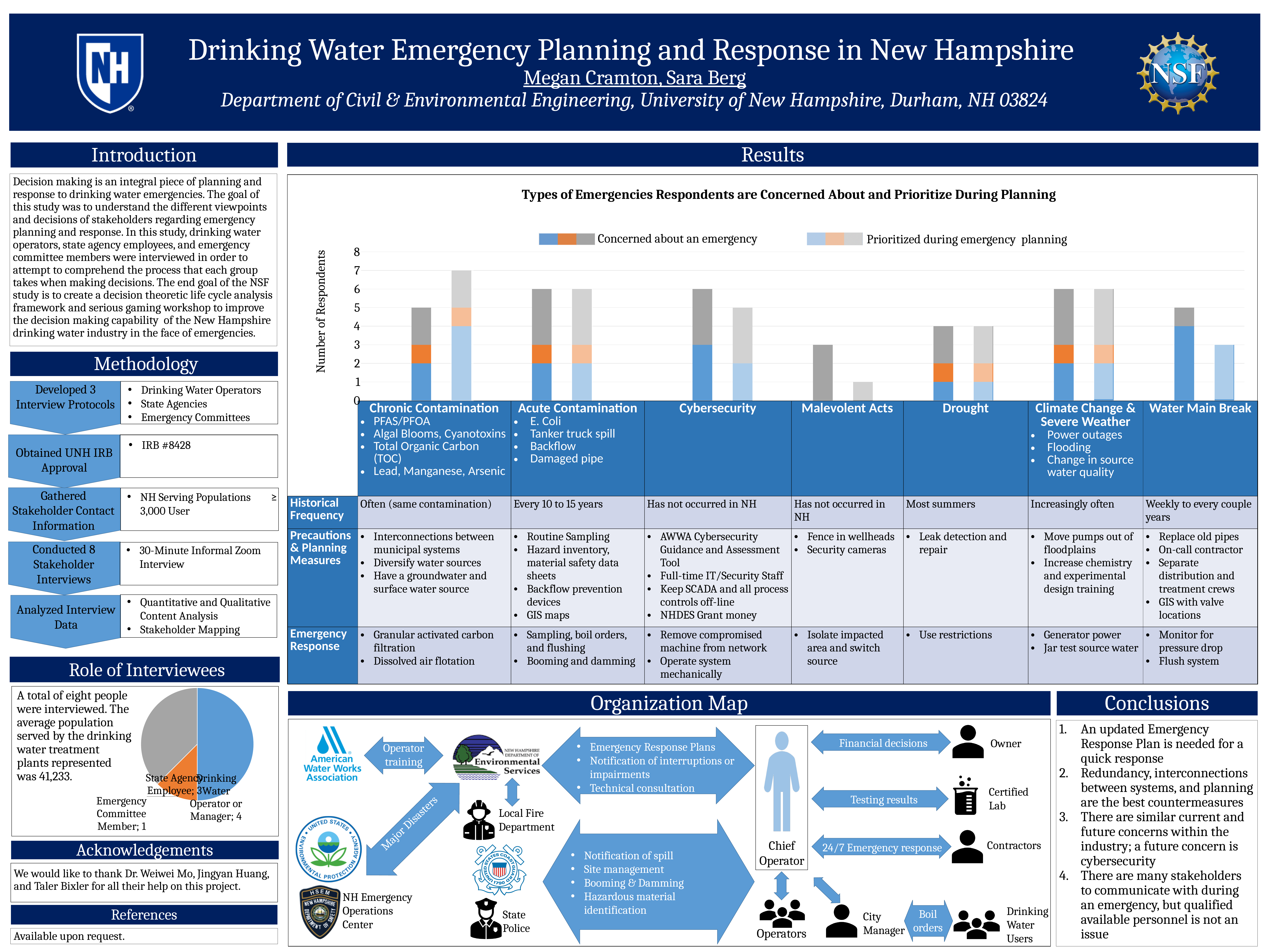
In the pie chart under 'Role of Interviewees', which role has the smallest slice? Emergency Committee Member In the pie chart under 'Role of Interviewees', what share of the interviewees were Drinking Water Operators or Managers? 50% In the 'Types of Emergencies' bar chart, how many emergency categories are shown on the x axis? 7 In the 'Types of Emergencies' bar chart, what is the total number of respondents for the 'Prioritized during emergency planning' bar for Chronic Contamination? 7 In the 'Types of Emergencies' bar chart, which category has the shortest 'Prioritized during emergency planning' bar? Malevolent Acts In the 'Types of Emergencies' bar chart, what is the difference between the 'Concerned about an emergency' total and the 'Prioritized during emergency planning' total for Water Main Break? 2 In the 'Types of Emergencies' bar chart, how many series does the legend list? 2 In the 'Types of Emergencies' bar chart, for Malevolent Acts, which bar is taller: 'Concerned about an emergency' or 'Prioritized during emergency planning'? Concerned about an emergency What kind of chart is 'Types of Emergencies Respondents are Concerned About and Prioritize During Planning'? Stacked bar chart In the pie chart under 'Role of Interviewees', how many interviewees were Drinking Water Operators or Managers? 4 In the 'Types of Emergencies' bar chart, which category has the tallest 'Prioritized during emergency planning' bar? Chronic Contamination In the 'Types of Emergencies' bar chart, is the 'Concerned about an emergency' total for Drought greater or less than 5? less